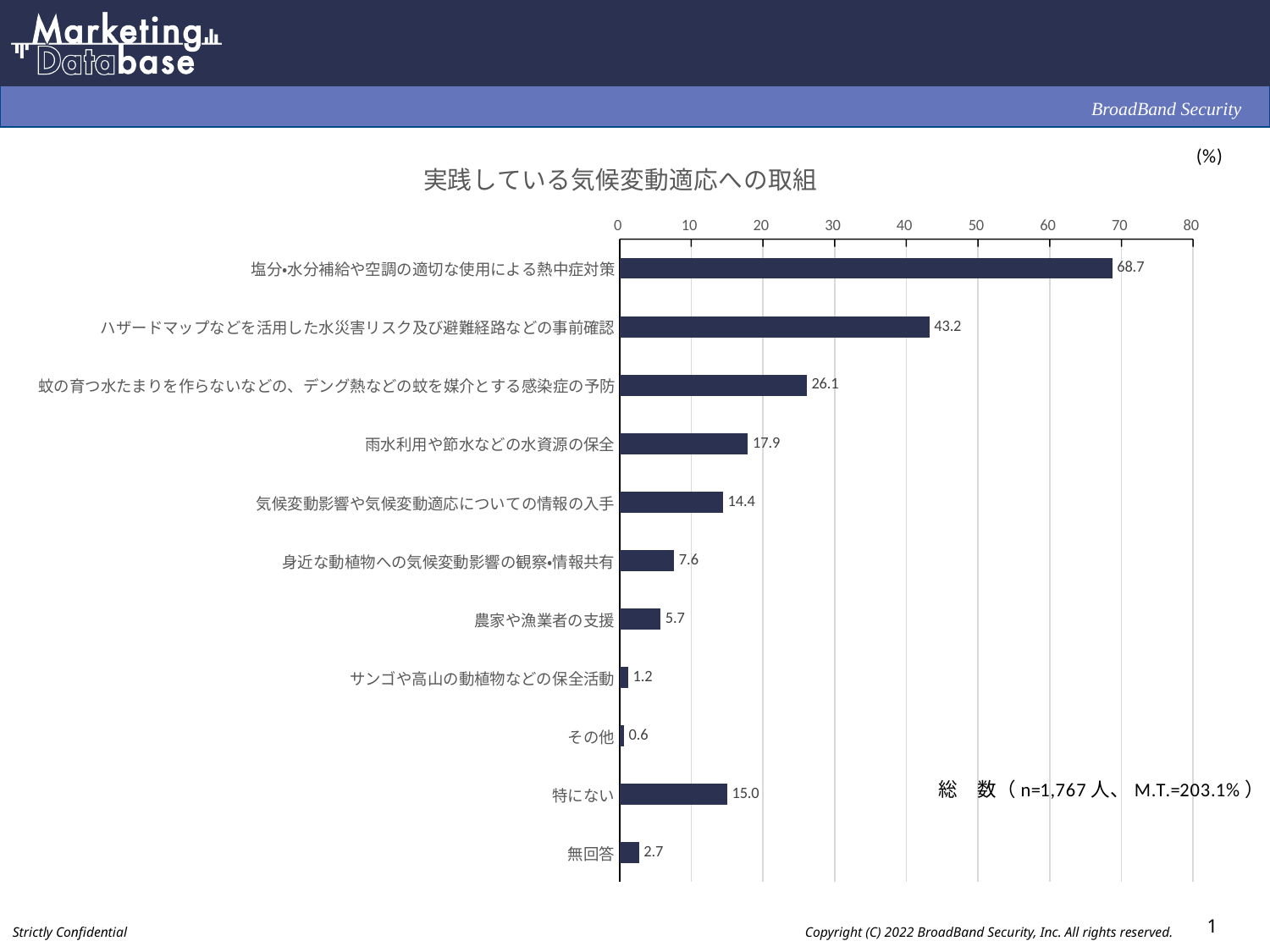
How many categories are plotted in the chart? 11 What is the title of the chart? 実践している気候変動適応への取組 What is the value for 塩分•水分補給や空調の適切な使用による熱中症対策? 68.7 What is the value for 雨水利用や節水などの水資源の保全? 17.9 Is the value for 蚊の育つ水たまりを作らないなどの、デング熱などの蚊を媒介とする感染症の予防 greater or less than 20? greater What is the value for 無回答? 2.7 Which category has the highest value? 塩分•水分補給や空調の適切な使用による熱中症対策 What is the value for 特にない? 15.0 What type of chart is shown on the slide? Bar chart Which category has the lowest value? その他 What is the difference between the values for 塩分•水分補給や空調の適切な使用による熱中症対策 and ハザードマップなどを活用した水災害リスク及び避難経路などの事前確認? 25.5 Which is larger, the value for 農家や漁業者の支援 or the value for 身近な動植物への気候変動影響の観察•情報共有? 身近な動植物への気候変動影響の観察•情報共有